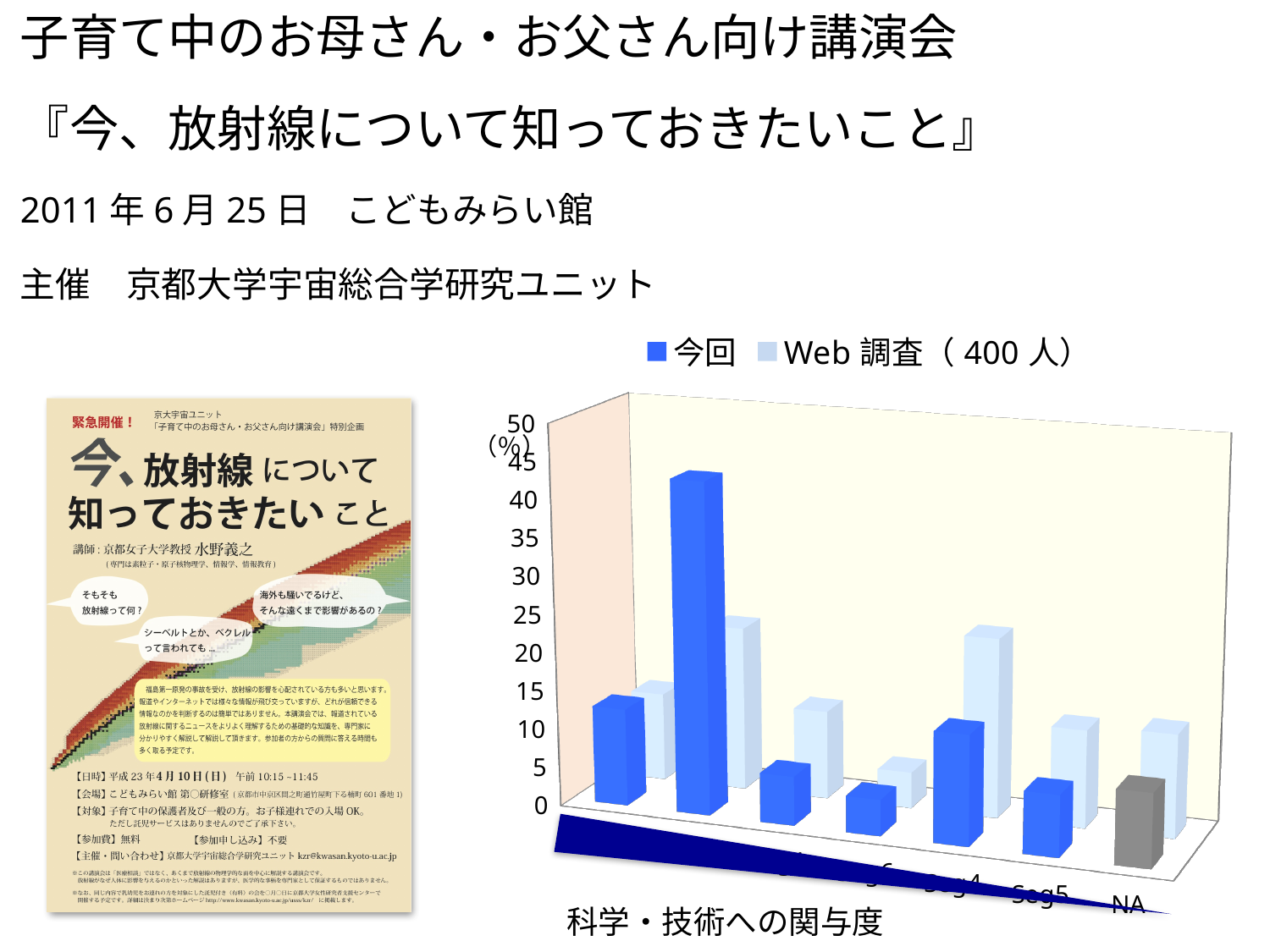
Is the Web 調査 value for Seg4 greater or less than 15? greater Is the 今回 value for Seg5 greater or less than 10? less What kind of chart is shown on the slide? bar chart What is the highest tick value shown on the chart's y axis? 50 Is the 今回 value for Seg4 greater or less than 20? less How many categories are plotted along the x axis of the chart? 7 What are the two series named in the chart legend? 今回 and Web 調査（400 人） For Seg5, which series has the larger value, 今回 or Web 調査? Web 調査 What is the title of the chart's x axis? 科学・技術への関与度 For Seg4, which series has the larger value, 今回 or Web 調査? Web 調査 How many series does the chart legend list? 2